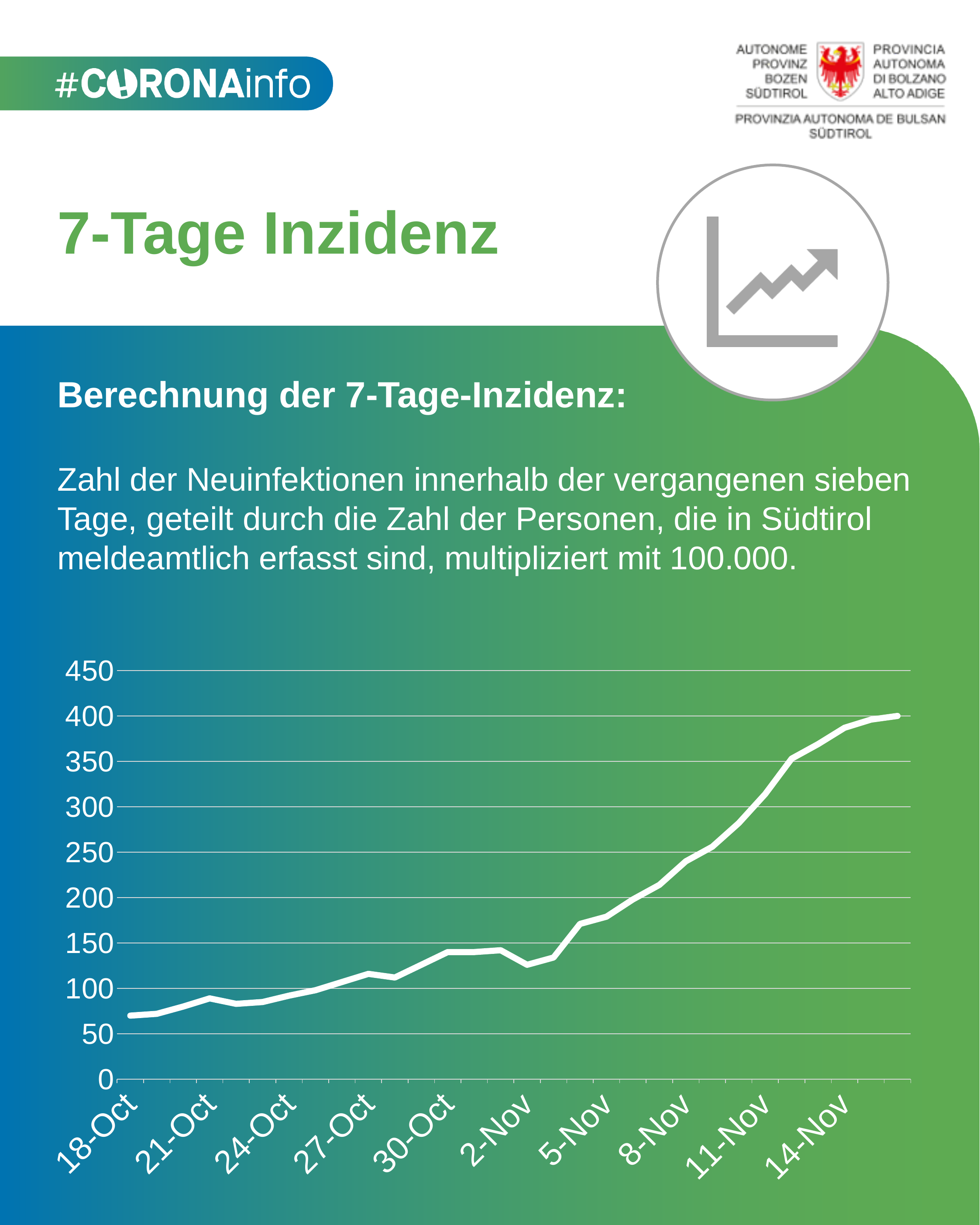
What kind of chart is shown on the slide? line chart Is the value for 18-Oct greater or less than 100? less Which is larger, the value for 14-Nov or the value for 18-Oct? 14-Nov Do the values in the chart generally rise or fall from 18-Oct to 14-Nov? rise Is the value for 30-Oct greater or less than 100? greater Is the value for 24-Oct greater or less than 100? less How many date labels are shown on the x axis? 10 Which labelled date on the x axis has the highest value? 14-Nov What is the highest value shown on the y axis of the chart? 450 Which labelled date on the x axis has the lowest value? 18-Oct